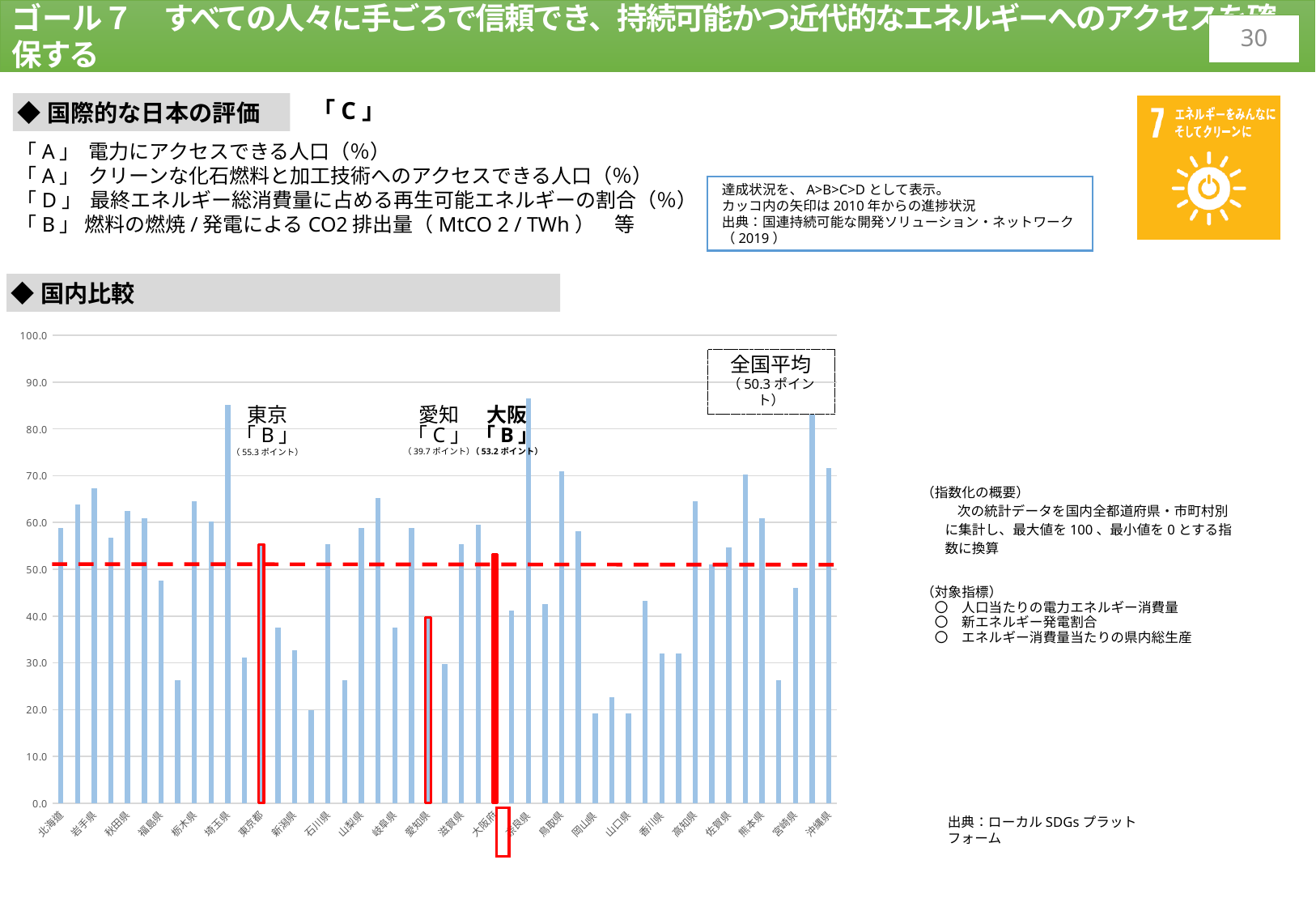
By how many points does 東京 exceed 大阪 on the 国内比較 chart? 2.1 ポイント Which has the larger value on the 国内比較 chart, 東京 or 愛知? 東京 What is the difference between the values for 大阪 and 愛知 on the 国内比較 chart? 13.5 ポイント Is the value for 奈良県 on the 国内比較 chart greater or less than 50.0? greater What is the value shown for 東京 on the 国内比較 chart? 55.3 ポイント Is the value for 岡山県 on the 国内比較 chart greater or less than 30.0? less What is the value shown for 大阪 on the 国内比較 chart? 53.2 ポイント What rating letter is shown for 愛知 on the 国内比較 chart? C What is the 全国平均 value indicated on the 国内比較 chart? 50.3 ポイント Is the value for 北海道 on the 国内比較 chart greater or less than 50.0? greater What kind of chart is the 国内比較 chart? bar chart What is the value shown for 愛知 on the 国内比較 chart? 39.7 ポイント